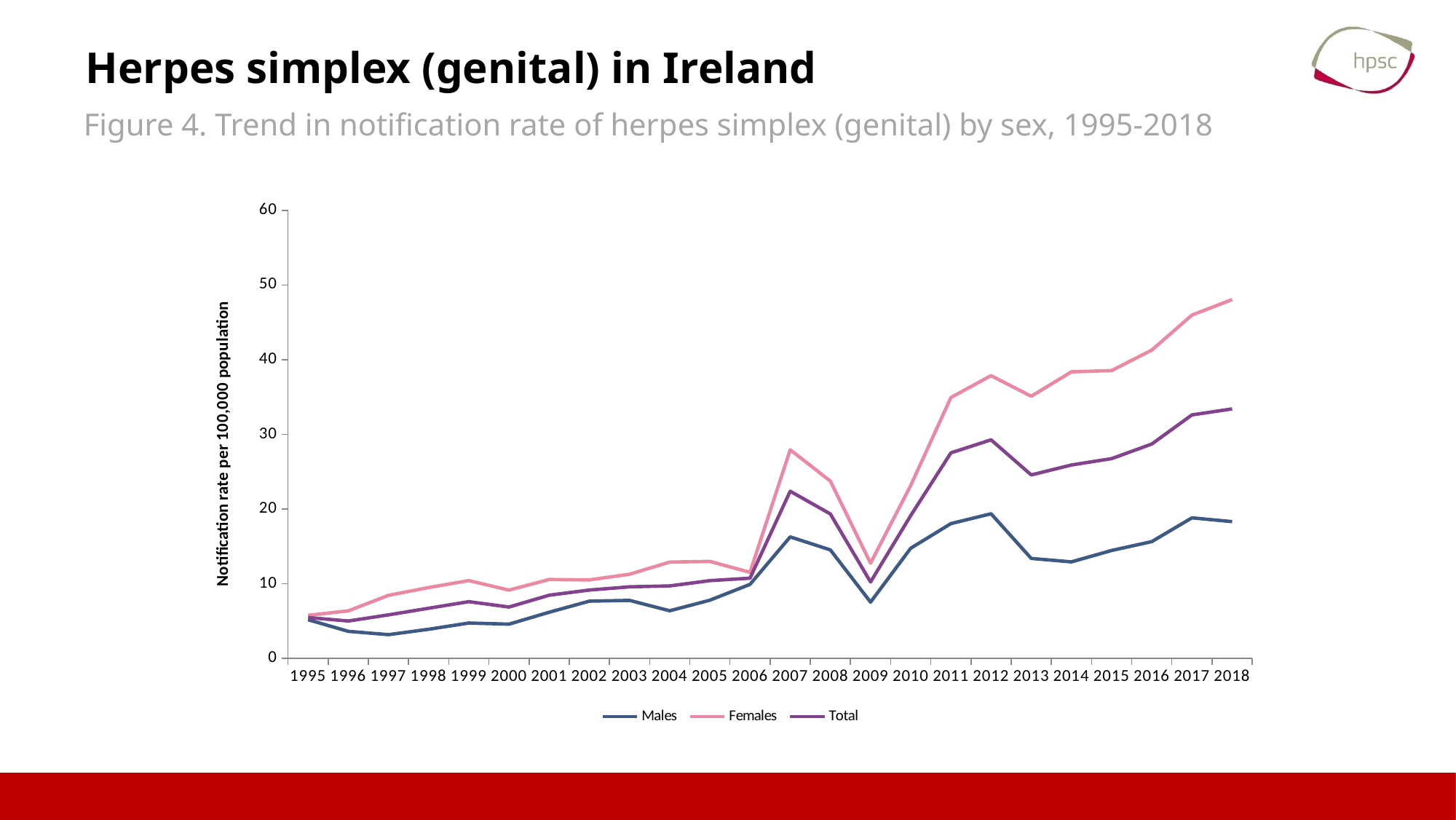
What kind of chart is shown on the slide? line chart How many series does the legend list? 3 Is the value for Males in 2018 greater or less than 20? less Is the value for Total in 2007 greater or less than 20? greater In which year does the Females series reach its highest value? 2018 Overall, does the Females notification rate rise or fall from 1995 to 2018? rise How many years are shown along the x axis? 24 Which series has the lowest notification rate in 2018? Males Is the value for Females in 2018 greater or less than 40? greater What is the label on the y axis? Notification rate per 100,000 population Which series has the highest notification rate in 2018? Females